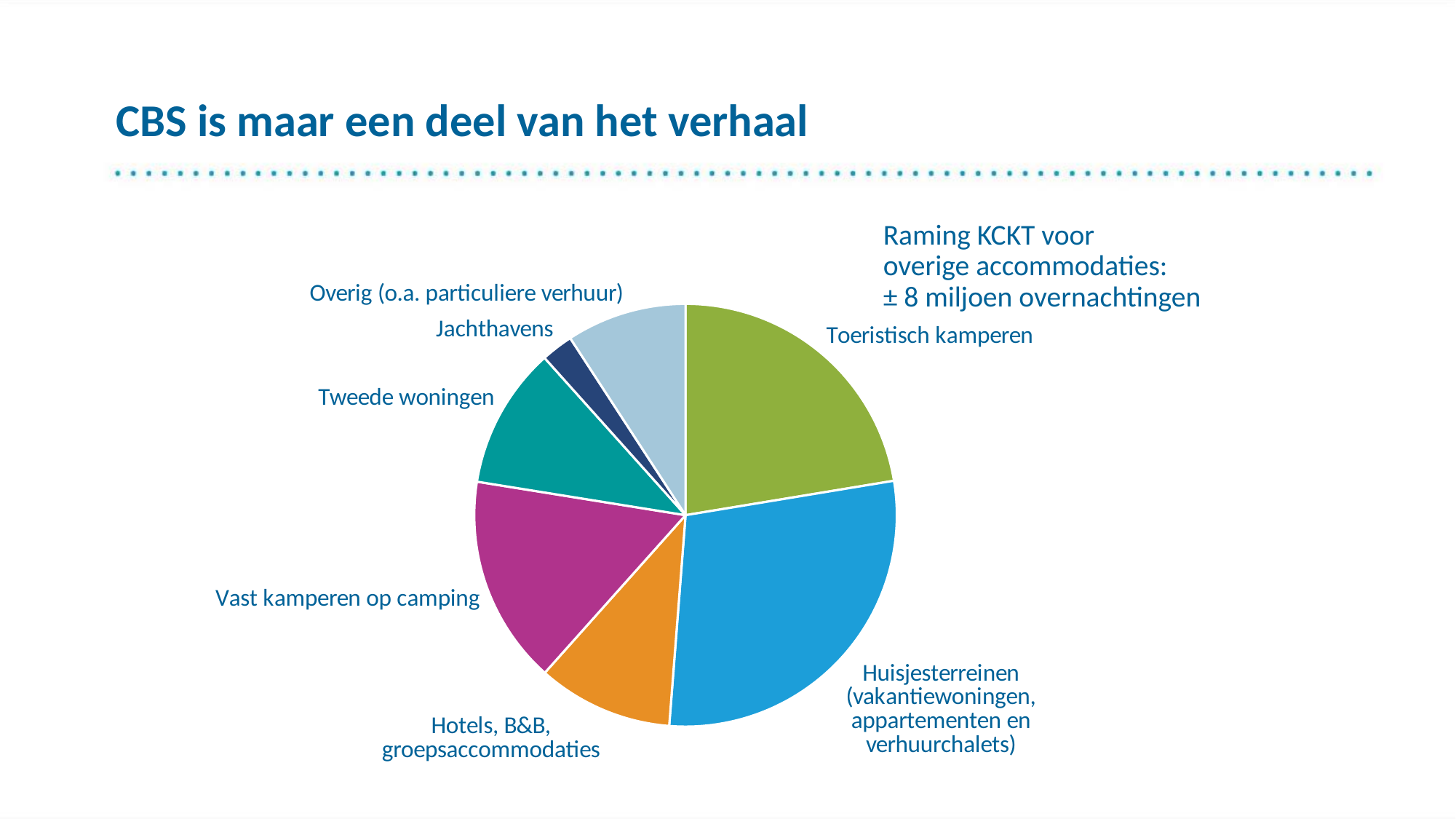
What is the title of the slide containing the pie chart? CBS is maar een deel van het verhaal What colour is the Toeristisch kamperen slice of the pie chart? green Which slice is larger: Vast kamperen op camping or Hotels, B&B, groepsaccommodaties? Vast kamperen op camping Which category has the smallest slice of the pie chart? Jachthavens Which slice is larger: Toeristisch kamperen or Hotels, B&B, groepsaccommodaties? Toeristisch kamperen How many slices does the pie chart have? 7 Which category has the largest slice of the pie chart? Huisjesterreinen (vakantiewoningen, appartementen en verhuurchalets) Which slice is larger: Huisjesterreinen or Toeristisch kamperen? Huisjesterreinen What kind of chart is shown on the slide? pie chart